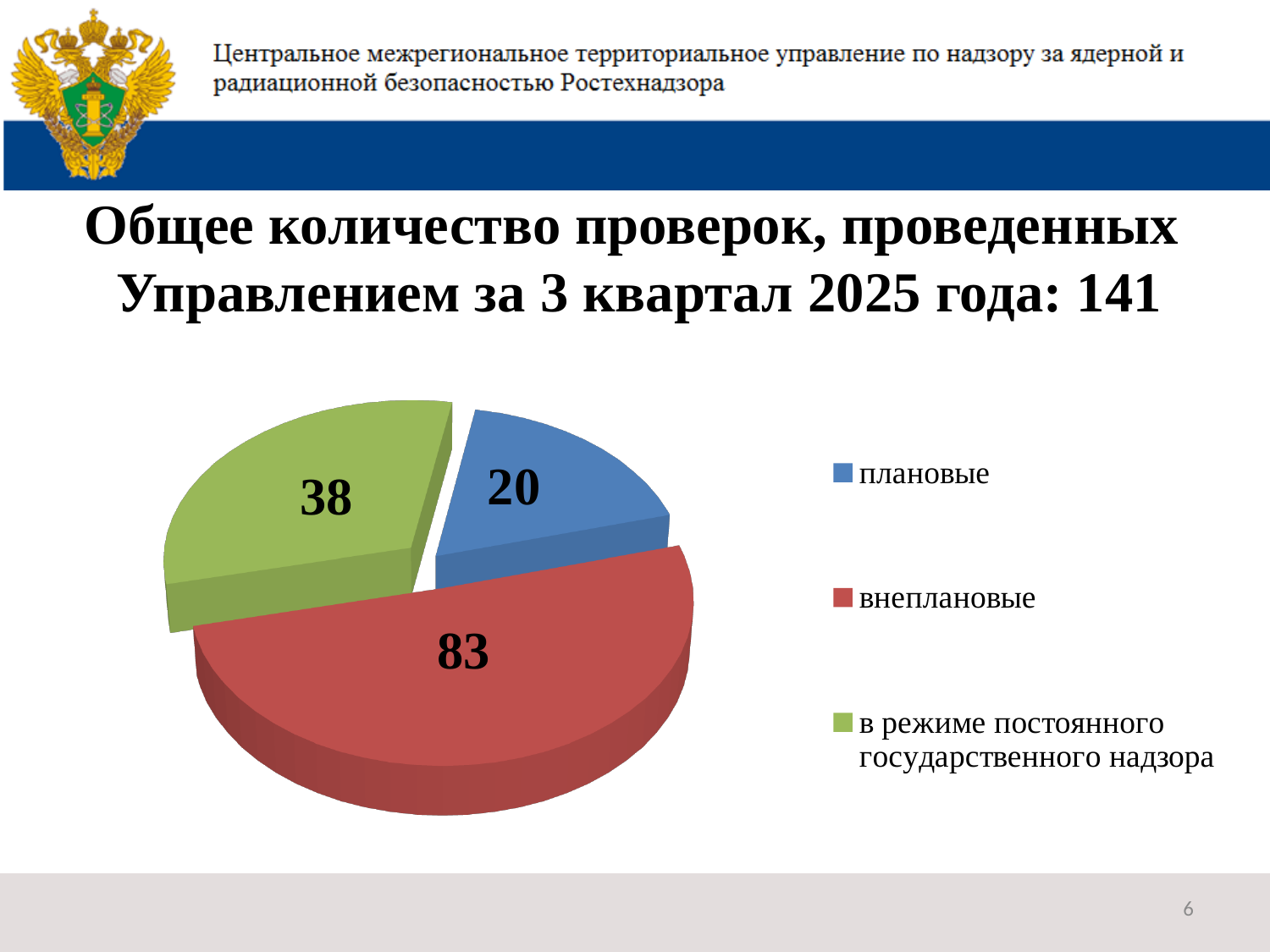
What value is shown for the slice 'в режиме постоянного государственного надзора'? 38 What type of chart is shown on the slide? pie chart How many entries does the legend list? 3 Which category has the largest slice of the pie? внеплановые How many inspections are labelled as плановые in the pie chart? 20 What is the total number of inspections stated in the slide title? 141 Which is larger: the value for внеплановые or the value for 'в режиме постоянного государственного надзора'? внеплановые How many slices does the pie chart have? 3 What colour is the внеплановые slice? red What is the difference between the внеплановые and плановые values? 63 Which category has the smallest slice of the pie? плановые What value is shown for the внеплановые slice? 83